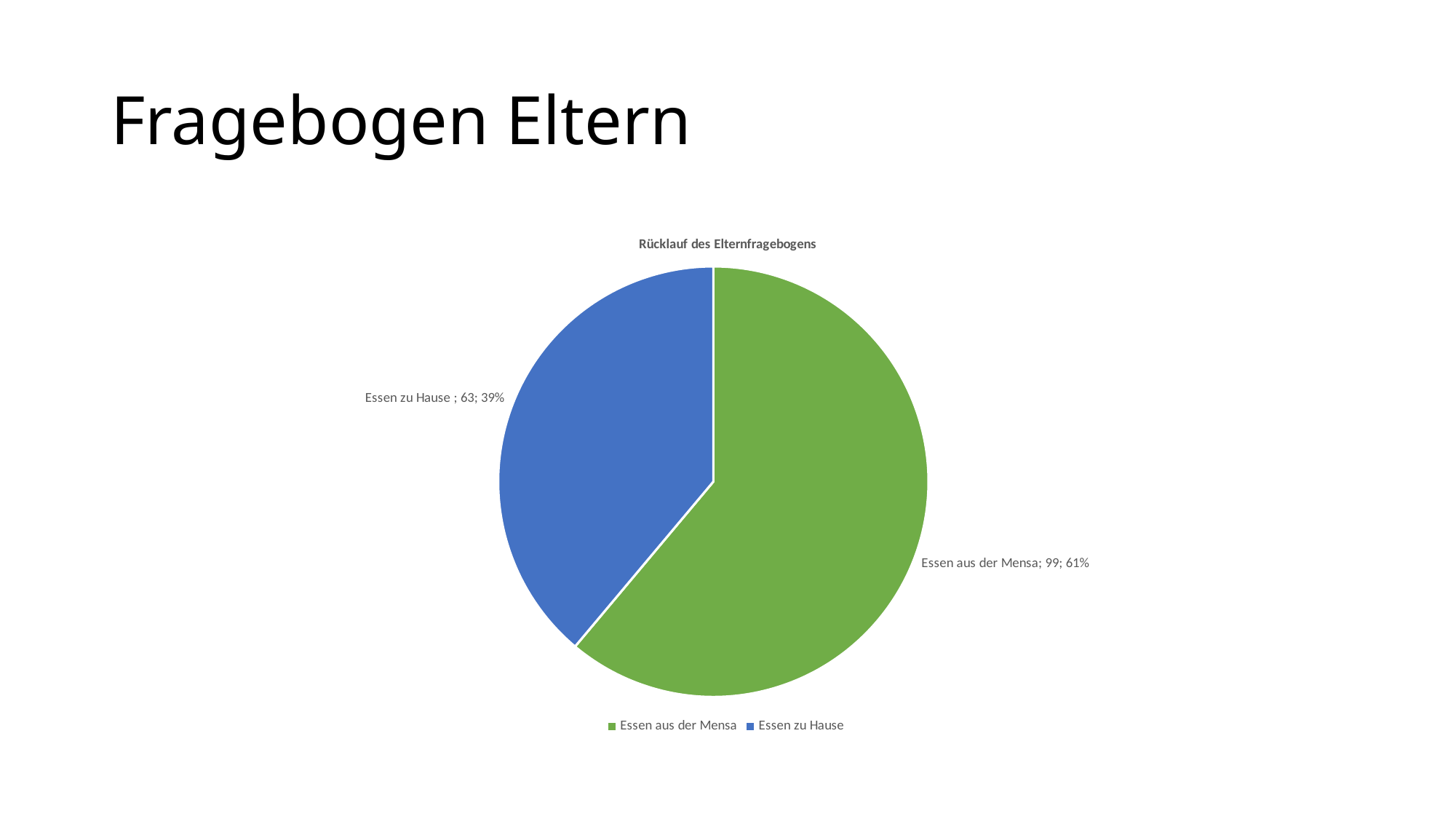
Which category has the largest slice? Essen aus der Mensa What is the difference between the values for Essen aus der Mensa and Essen zu Hause? 36 What kind of chart is shown on the slide? pie chart What is the value for Essen aus der Mensa? 99 How many entries does the legend list? 2 How many slices does the pie chart have? 2 Which colour represents Essen zu Hause in the chart? blue What is the value for Essen zu Hause? 63 What is the title of the chart? Rücklauf des Elternfragebogens What share of the pie does Essen zu Hause represent? 39% Which category has the smallest slice? Essen zu Hause What share of the pie does Essen aus der Mensa represent? 61%